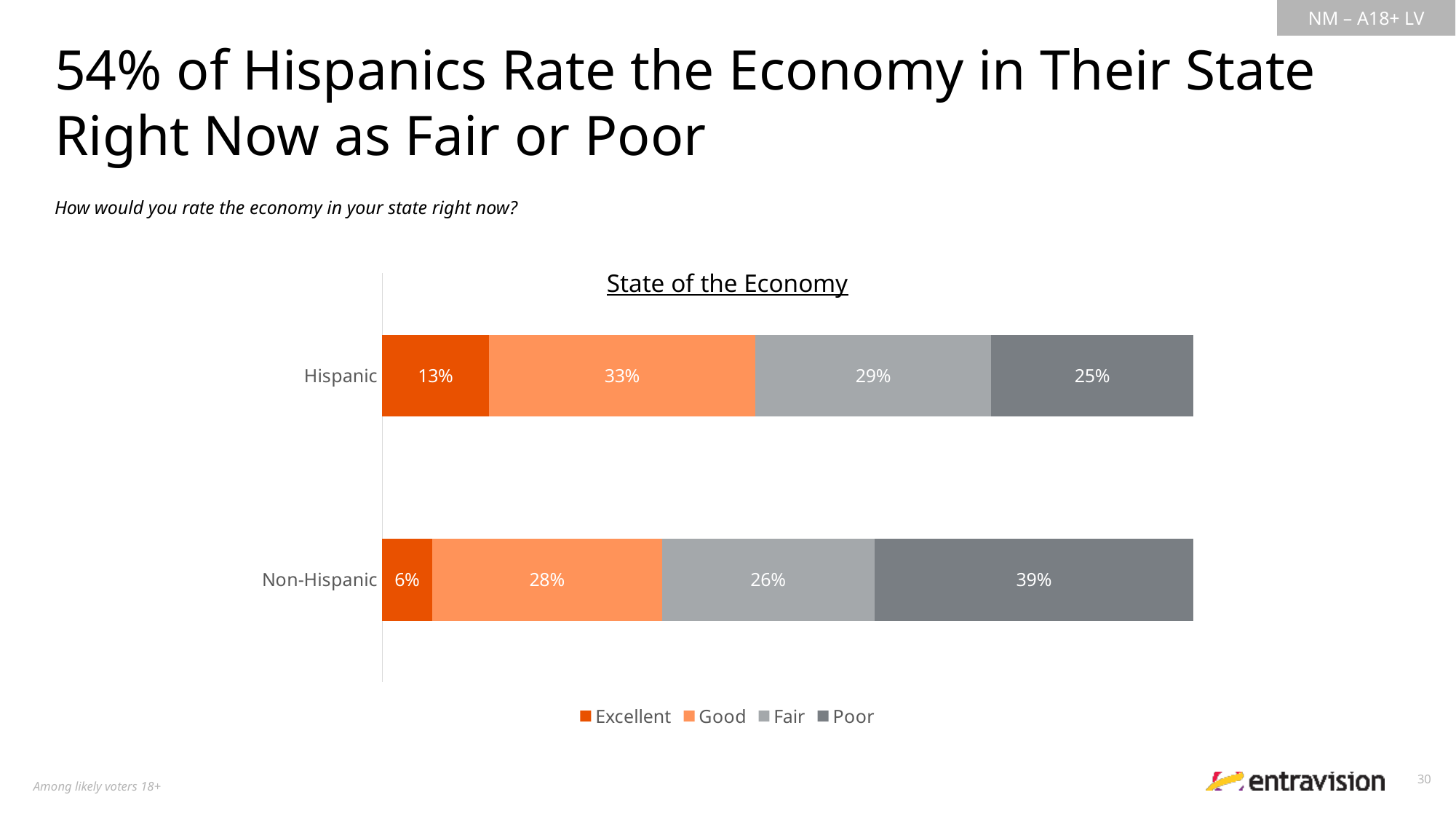
What is the difference between the Poor share for Non-Hispanics and for Hispanics? 14 percentage points How many series does the legend list? 4 What percentage of Non-Hispanics rate the economy as Fair? 26% Which rating has the largest share among Hispanics? Good What type of chart is shown on the slide? Stacked bar chart Which rating has the smallest share among Non-Hispanics? Excellent What percentage of Hispanics rate the economy as Good? 33% Which group has a larger share rating the economy as Excellent, Hispanic or Non-Hispanic? Hispanic What percentage of Non-Hispanics rate the economy in their state as Poor? 39% What percentage of Hispanics rate the economy in their state as Excellent? 13% How many groups are shown in the chart? 2 What is the combined share of Hispanics rating the economy as Fair or Poor? 54%